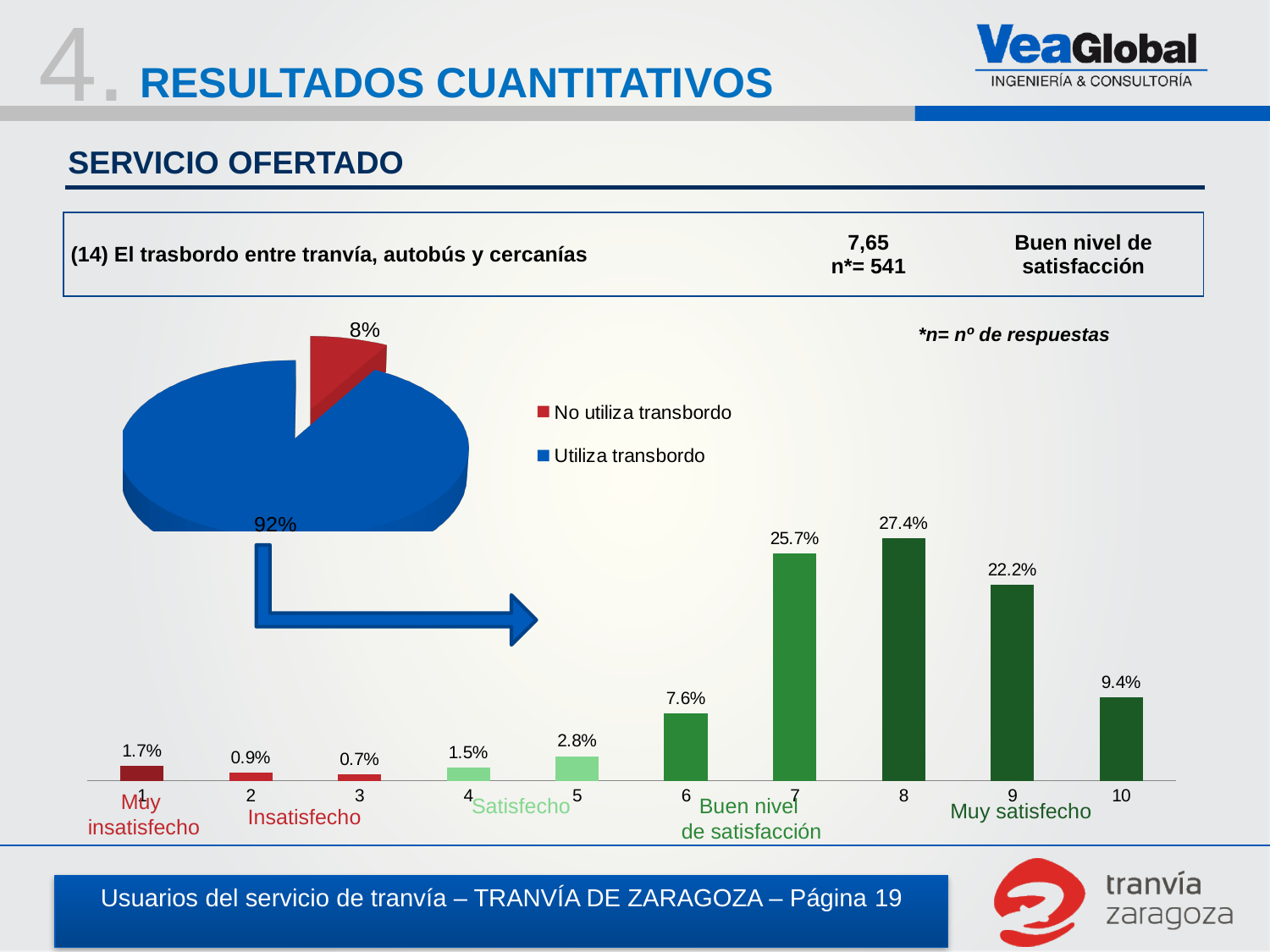
What kind of chart is the one at the bottom of the slide showing satisfaction scores from 1 to 10? Bar chart How many entries does the legend of the pie chart list? 2 In the bar chart of satisfaction scores, what is the value for score 3? 0.7% In the bar chart of satisfaction scores, which score has the highest value? 8 In the pie chart, what share of respondents does 'Utiliza transbordo' represent? 92% In the pie chart, what share of respondents does 'No utiliza transbordo' represent? 8% In the bar chart of satisfaction scores, which is larger: the value for score 9 or the value for score 10? Score 9 How many score categories are shown on the x axis of the bar chart? 10 In the pie chart, which colour represents 'No utiliza transbordo'? Red In the bar chart of satisfaction scores, what is the difference between the values for score 8 and score 7? 1.7% In the bar chart of satisfaction scores, what is the value for score 8? 27.4% In the bar chart of satisfaction scores, which score has the lowest value? 3